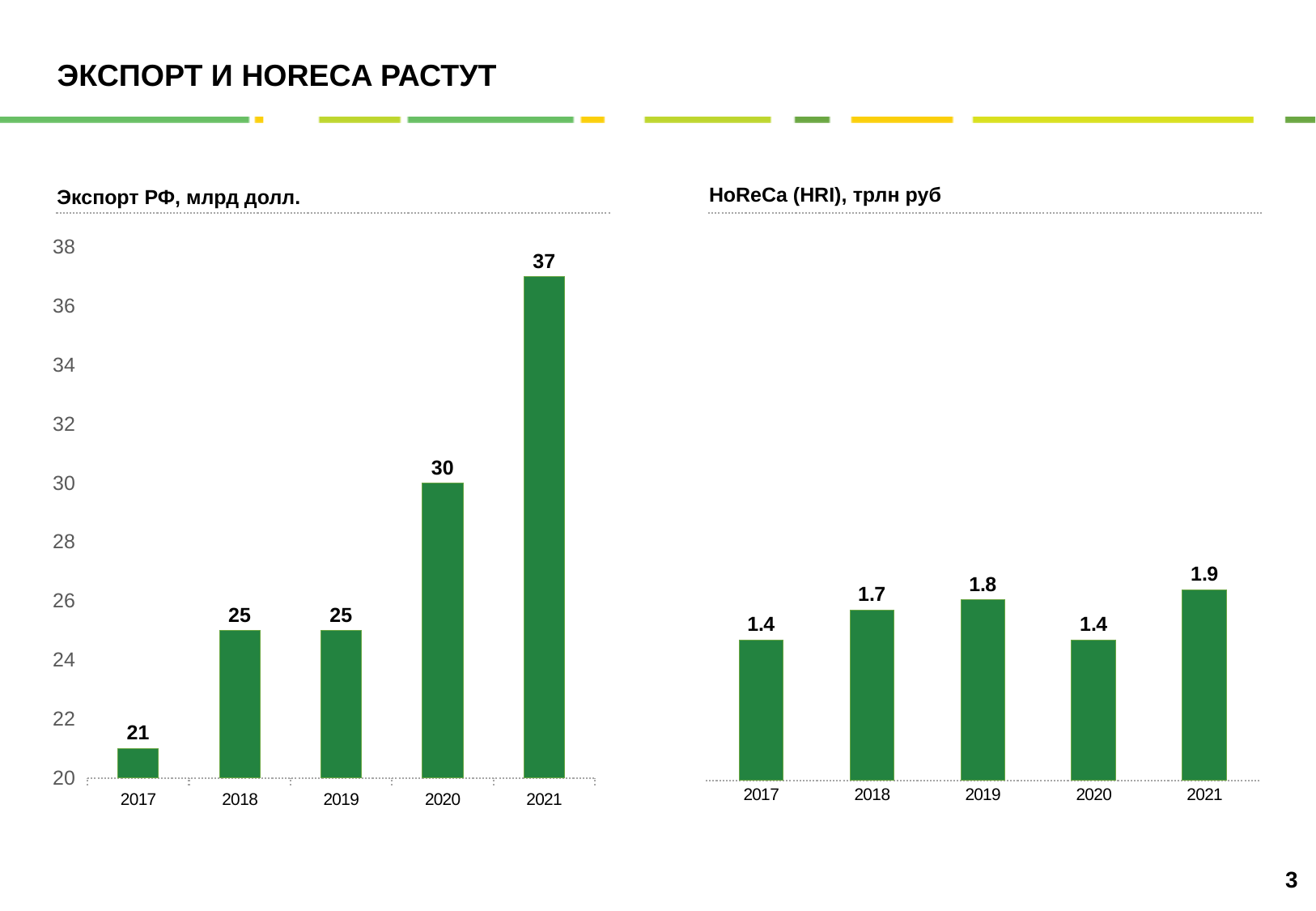
In the 'Экспорт РФ, млрд долл.' chart, is the value for 2020 greater or less than 28? greater In the 'HoReCa (HRI), трлн руб' chart, what is the value for 2019? 1.8 In the 'Экспорт РФ, млрд долл.' chart, how many years are shown on the x axis? 5 In the 'Экспорт РФ, млрд долл.' chart, what is the difference between the 2021 and 2020 values? 7 In the 'Экспорт РФ, млрд долл.' chart, which year has the lowest value? 2017 What is the title of the slide? ЭКСПОРТ И HORECA РАСТУТ In the 'HoReCa (HRI), трлн руб' chart, which is larger, the value for 2018 or the value for 2020? 2018 In the 'HoReCa (HRI), трлн руб' chart, what is the difference between the 2021 and 2017 values? 0.5 In the 'HoReCa (HRI), трлн руб' chart, which year has the highest value? 2021 What type of chart is the 'HoReCa (HRI), трлн руб' chart? bar chart In the 'Экспорт РФ, млрд долл.' chart, what is the value for 2021? 37 In the 'Экспорт РФ, млрд долл.' chart, do the values generally rise or fall from 2017 to 2021? rise